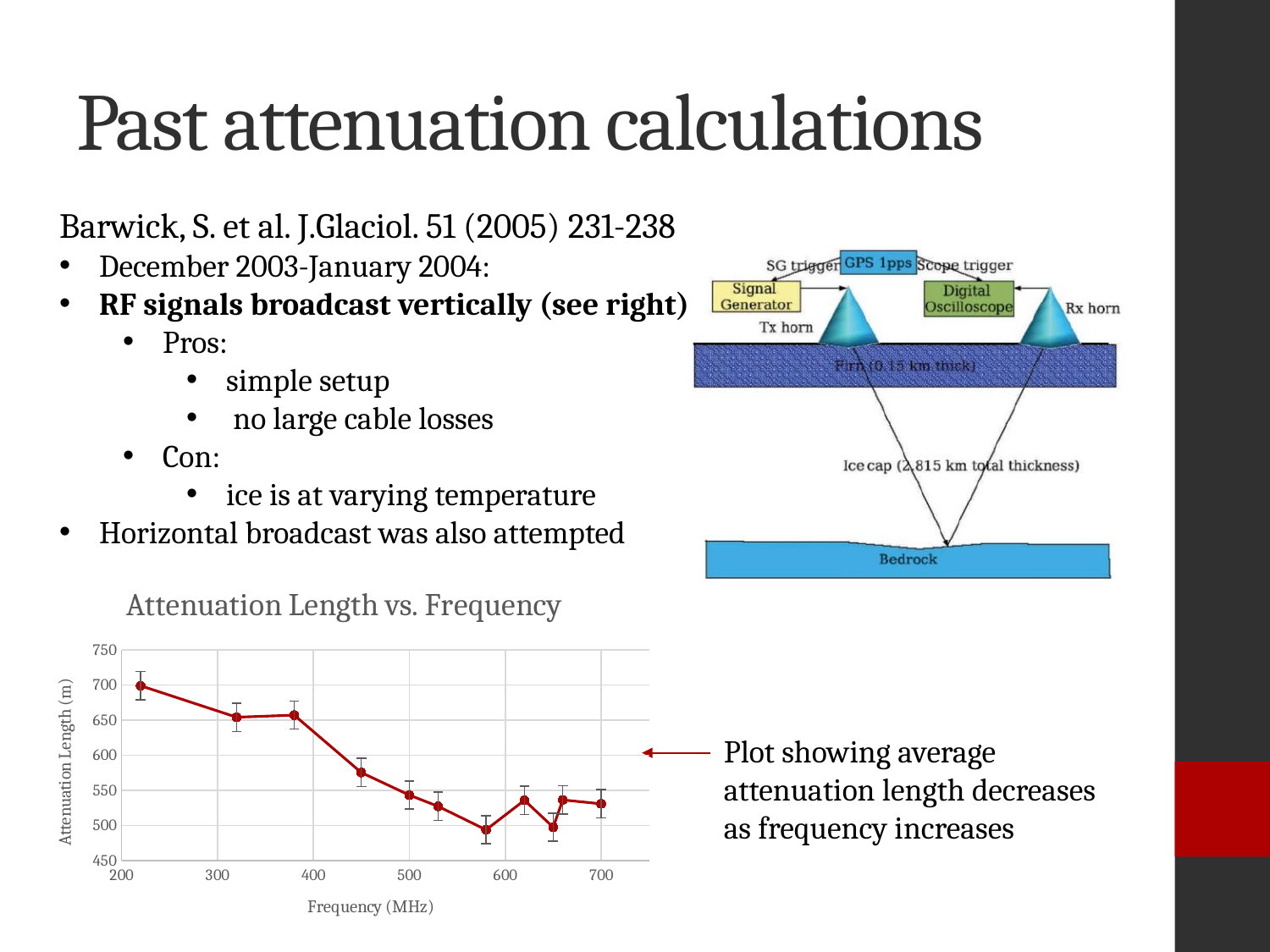
Which has the larger attenuation length: the point at about 320 MHz or the point at about 450 MHz? about 320 MHz Is the attenuation length at 700 MHz greater or less than 500? greater Is the attenuation length at 700 MHz greater or less than 550? less Is the attenuation length at the leftmost point (around 220 MHz) greater or less than 650? greater What kind of chart is shown on the slide? line chart What is the label of the y axis of the chart? Attenuation Length (m) How many data points are plotted on the chart? 11 Does the attenuation length generally rise or fall as frequency increases along the x axis? fall What is the title of the chart on the slide? Attenuation Length vs. Frequency